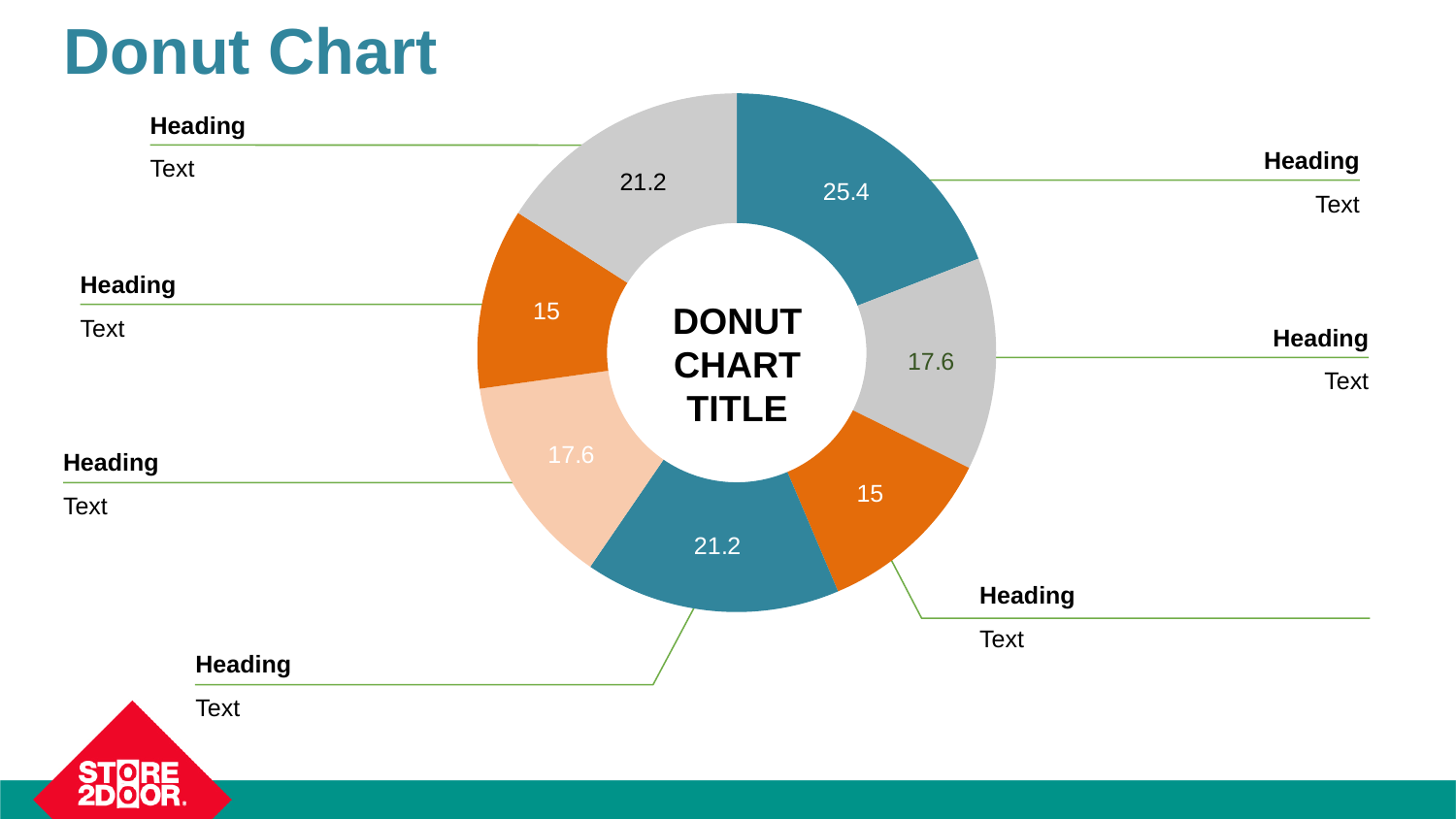
What is the smallest value shown on any segment of the donut chart? 15 What is the title of the slide? Donut Chart What value is shown on the light peach segment on the lower left of the donut chart? 17.6 What text is printed in the centre of the donut chart? DONUT CHART TITLE What is the total of all the segment values shown on the donut chart? 133 What is the difference between the largest segment value (25.4) and the smallest segment value (15)? 10.4 How many segments does the donut chart have? 7 How many segments of the donut chart are labelled 17.6? 2 What value is shown on the dark teal segment at the top of the donut chart? 25.4 What is the largest value shown on any segment of the donut chart? 25.4 What kind of chart is shown on the slide? Donut chart What is the difference between a segment labelled 21.2 and a segment labelled 17.6? 3.6